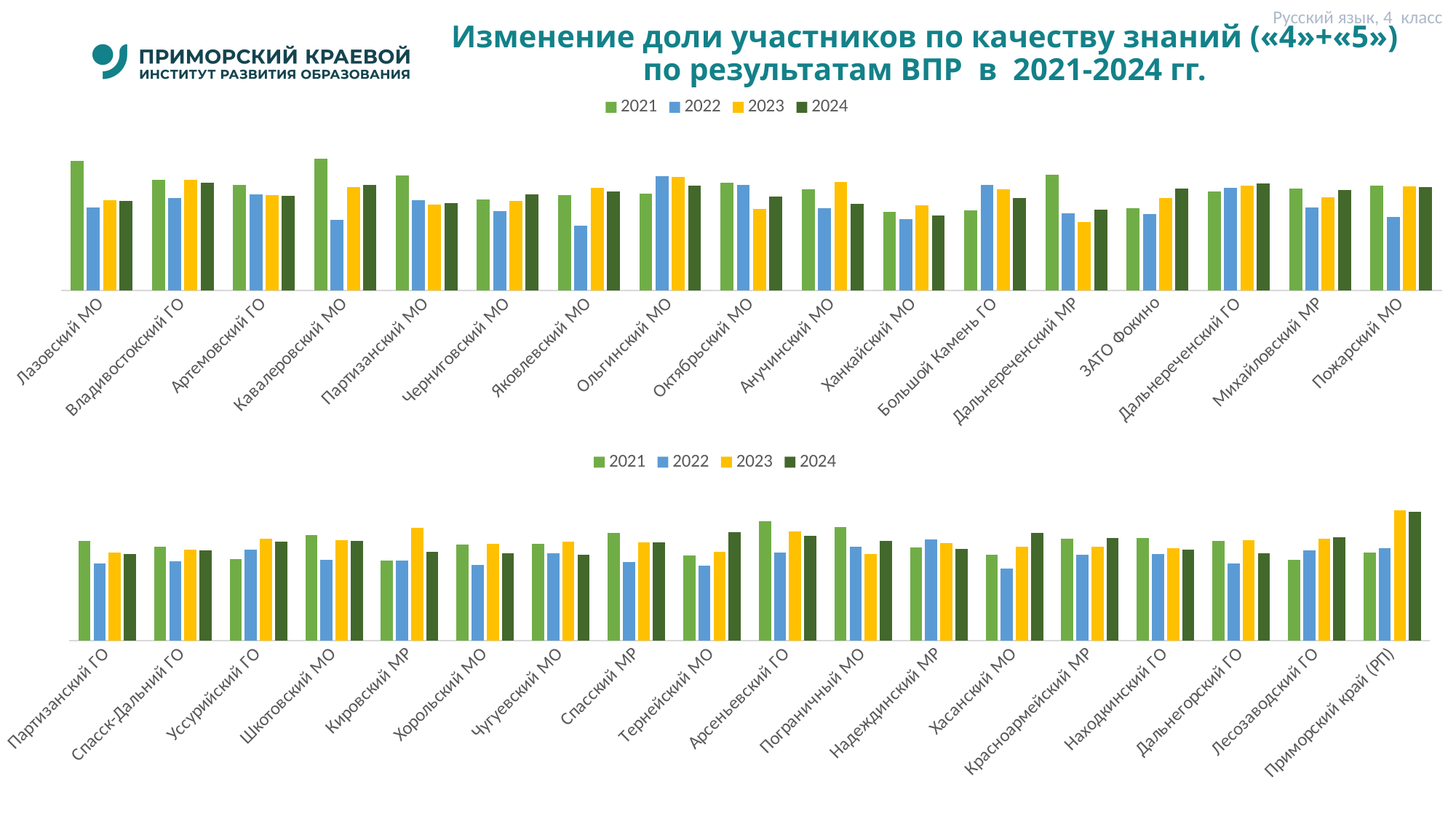
In the bottom chart, which category has the highest 2023 value? Приморский край (РП) In the bottom chart, for Кировский МР, which is larger: the 2022 value or the 2023 value? 2023 In the top chart, for Дальнереченский МР, which is larger: the 2021 value or the 2023 value? 2021 How many categories are shown on the x axis of the bottom chart? 18 In the top chart, for Лазовский МО, which is larger: the 2021 value or the 2022 value? 2021 Which years are listed in the legend of the bottom chart? 2021, 2022, 2023, 2024 Which subject and grade are indicated in the top right corner of the slide? Русский язык, 4 класс In the top chart, which category has the lowest 2022 value? Яковлевский МО In the bottom chart, which category has the highest 2024 value? Приморский край (РП) What kind of chart is the top chart on the slide? bar chart How many series does the legend of the top chart list? 4 How many categories are shown on the x axis of the top chart? 17